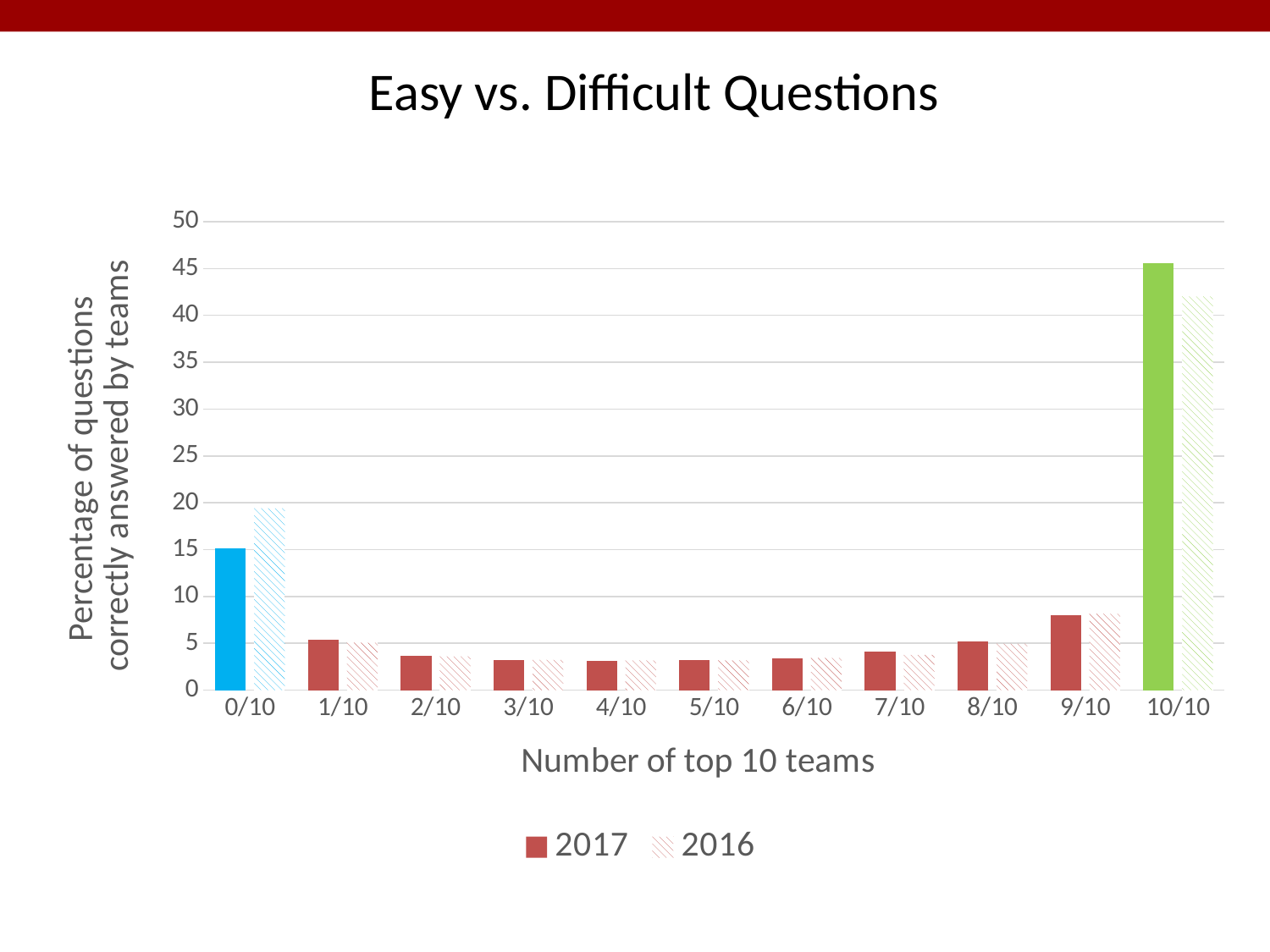
Which category has the highest value for the 2016 series? 10/10 For the 10/10 category, which series has the larger value, 2017 or 2016? 2017 Is the 2017 value for 0/10 greater or less than 10? greater What kind of chart is shown on the slide? bar chart Is the 2017 value for 9/10 greater or less than 10? less Is the 2017 value for 10/10 greater or less than 40? greater How many categories are shown on the x axis? 11 What is the title of the x axis? Number of top 10 teams How many series does the legend list? 2 For the 0/10 category, which series has the larger value, 2017 or 2016? 2016 Which category has the highest value for the 2017 series? 10/10